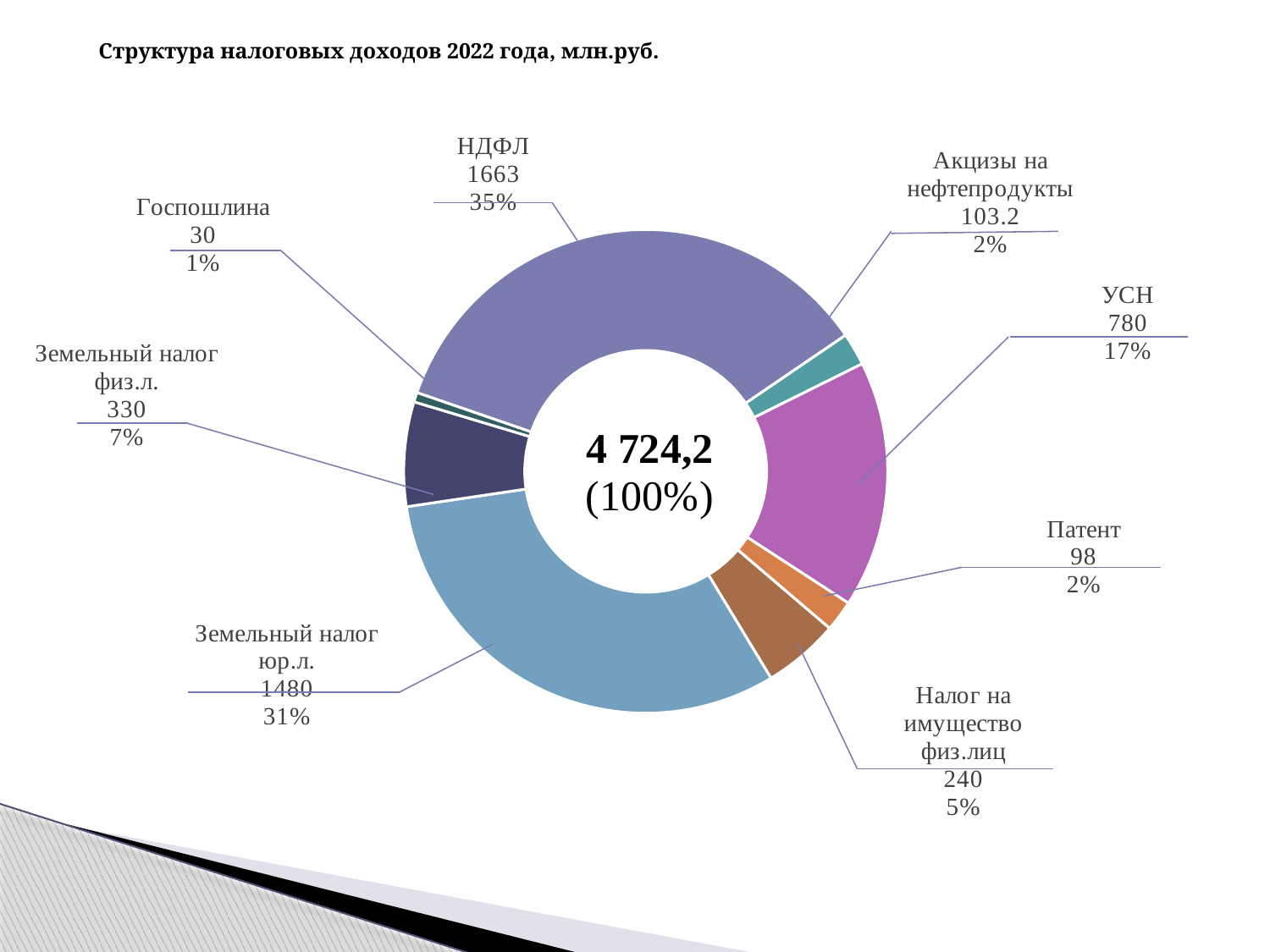
How many categories are shown in the chart? 8 What is the value for Акцизы на нефтепродукты? 103.2 What is the difference between the values for НДФЛ and Земельный налог юр.л.? 183 What kind of chart is shown on the slide? Doughnut (pie) chart What total value is shown in the centre of the chart? 4 724,2 What is the value for НДФЛ? 1663 Which is larger, the value for УСН or the value for Земельный налог физ.л.? УСН What is the value for УСН? 780 Which category has the largest share of the chart? НДФЛ What share of the chart does Налог на имущество физ.лиц represent? 5% Which category has the smallest value? Госпошлина What share of the chart does Земельный налог юр.л. represent? 31%